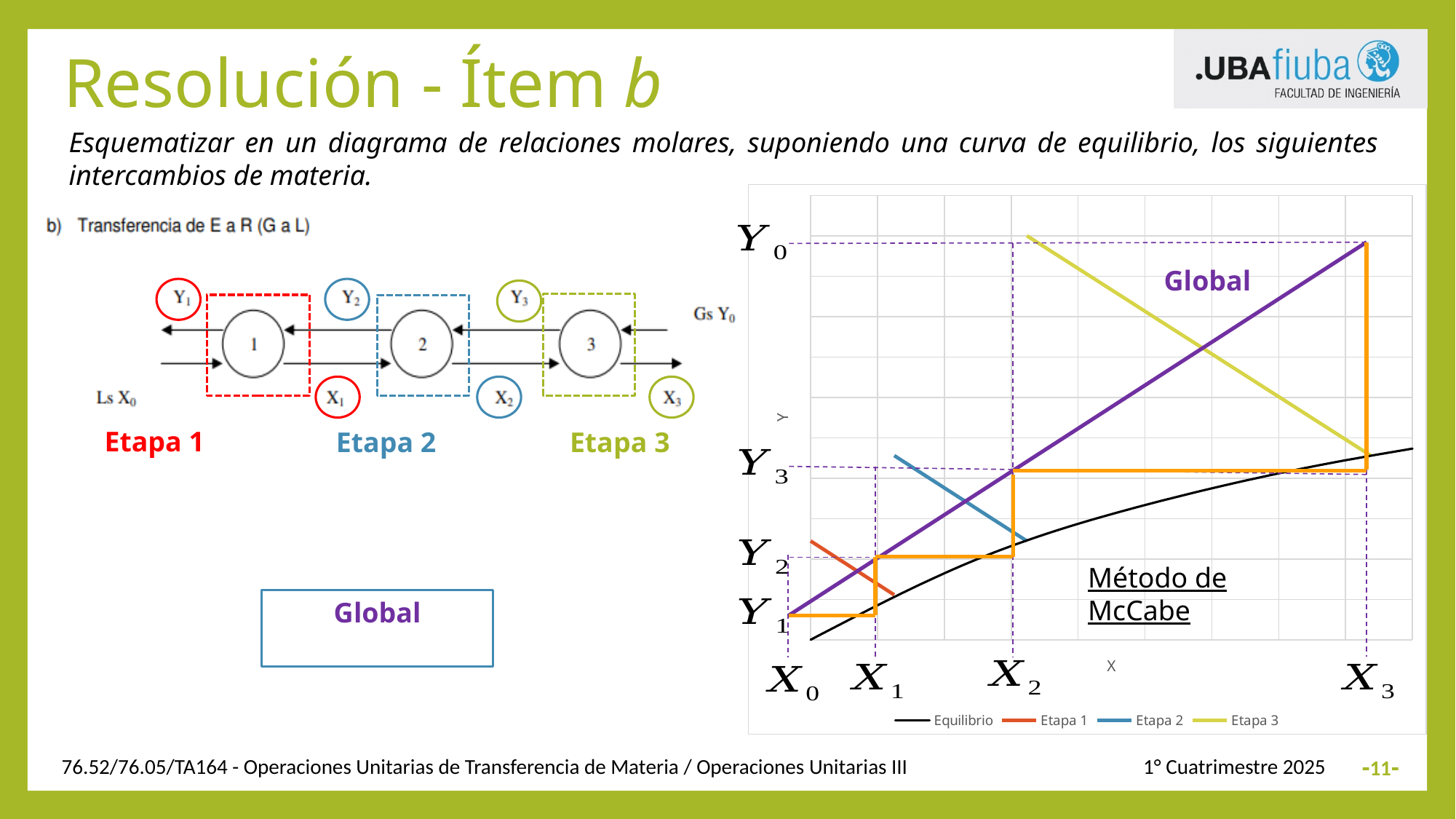
Does the Etapa 3 line rise or fall as X increases? Falls Which legend entry is drawn in black? Equilibrio How many X values are marked along the horizontal axis of the chart? 4 Does the Equilibrio curve rise or fall as X increases? Rises What are the four entries in the chart legend? Equilibrio, Etapa 1, Etapa 2, Etapa 3 What kind of chart is shown on the slide? Line chart Does the Global line rise or fall as X increases? Rises Which marked Y value is the highest on the vertical axis? Y0 How many series does the chart legend list? 4 Which marked X value is the lowest on the horizontal axis? X0 Which is larger, Y3 or Y2? Y3 How many Y values are marked along the vertical axis of the chart? 4